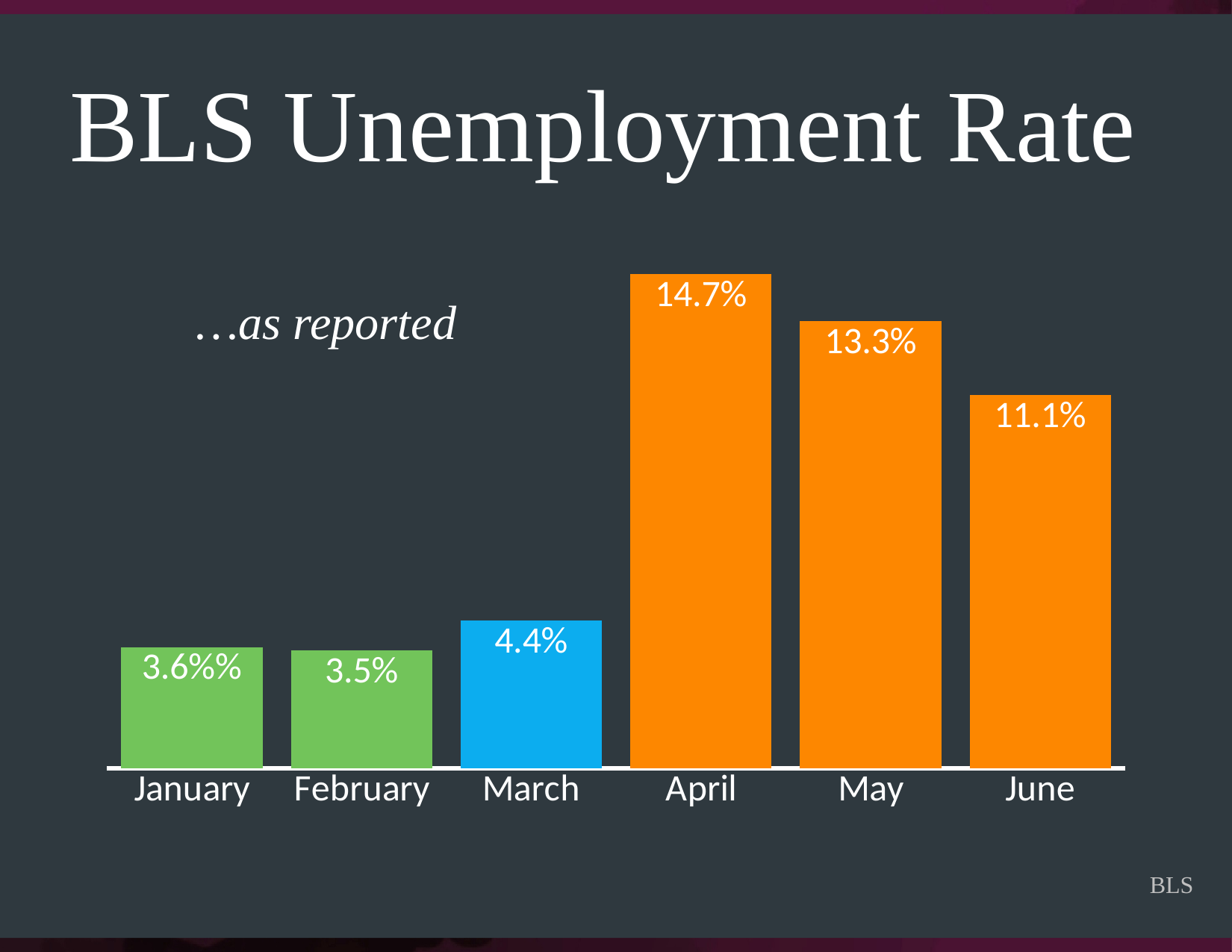
What is the unemployment rate shown for April? 14.7% Do the values rise or fall from April to June? Fall What is the difference between the May and June unemployment rates? 2.2% Which month has the highest unemployment rate? April What is the unemployment rate shown for March? 4.4% What is the unemployment rate shown for June? 11.1% What kind of chart is shown on the slide? Bar chart What is the unemployment rate shown for February? 3.5% How much higher is the April rate than the May rate? 1.4% Which month has the lowest unemployment rate? February Which is larger, the rate for March or the rate for February? March How many months are plotted in the chart? 6